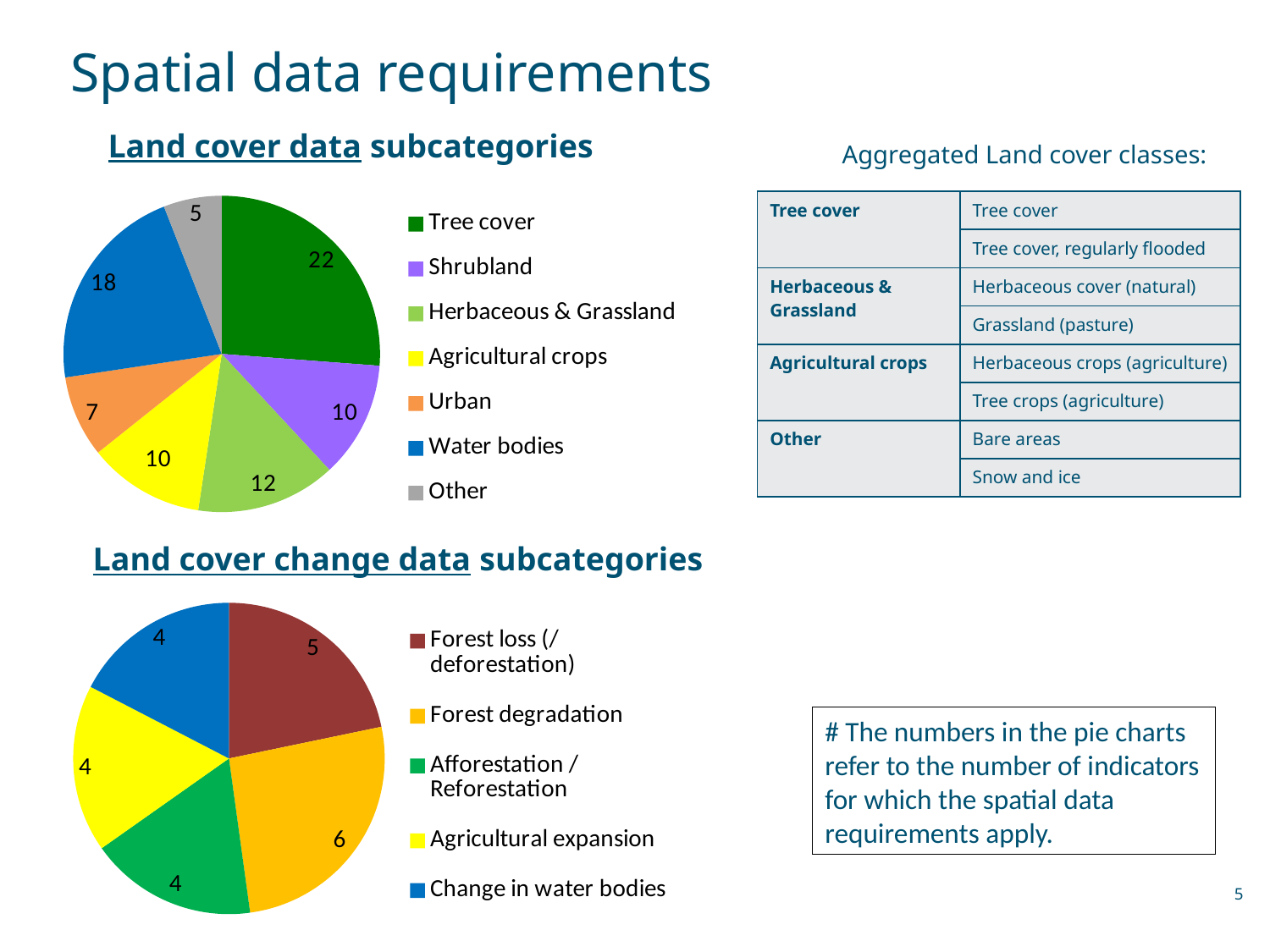
In the Land cover change data subcategories pie chart, what is the total of all the slice values? 23 In the Land cover data subcategories pie chart, what is the value for Tree cover? 22 In the Land cover data subcategories pie chart, which is larger: Herbaceous & Grassland or Shrubland? Herbaceous & Grassland In the Land cover change data subcategories pie chart, what is the value for Forest degradation? 6 In the Land cover change data subcategories pie chart, which category has the largest slice? Forest degradation How many categories does the Land cover data subcategories pie chart show? 7 In the Land cover data subcategories pie chart, what is the value for Water bodies? 18 In the Land cover data subcategories pie chart, which category has the largest slice? Tree cover In the Land cover data subcategories pie chart, what is the difference between the values for Tree cover and Urban? 15 In the Land cover data subcategories pie chart, which category has the smallest slice? Other In the Land cover change data subcategories pie chart, what colour is the Forest loss (/ deforestation) slice? Dark red What type of chart is used for the Land cover change data subcategories? Pie chart